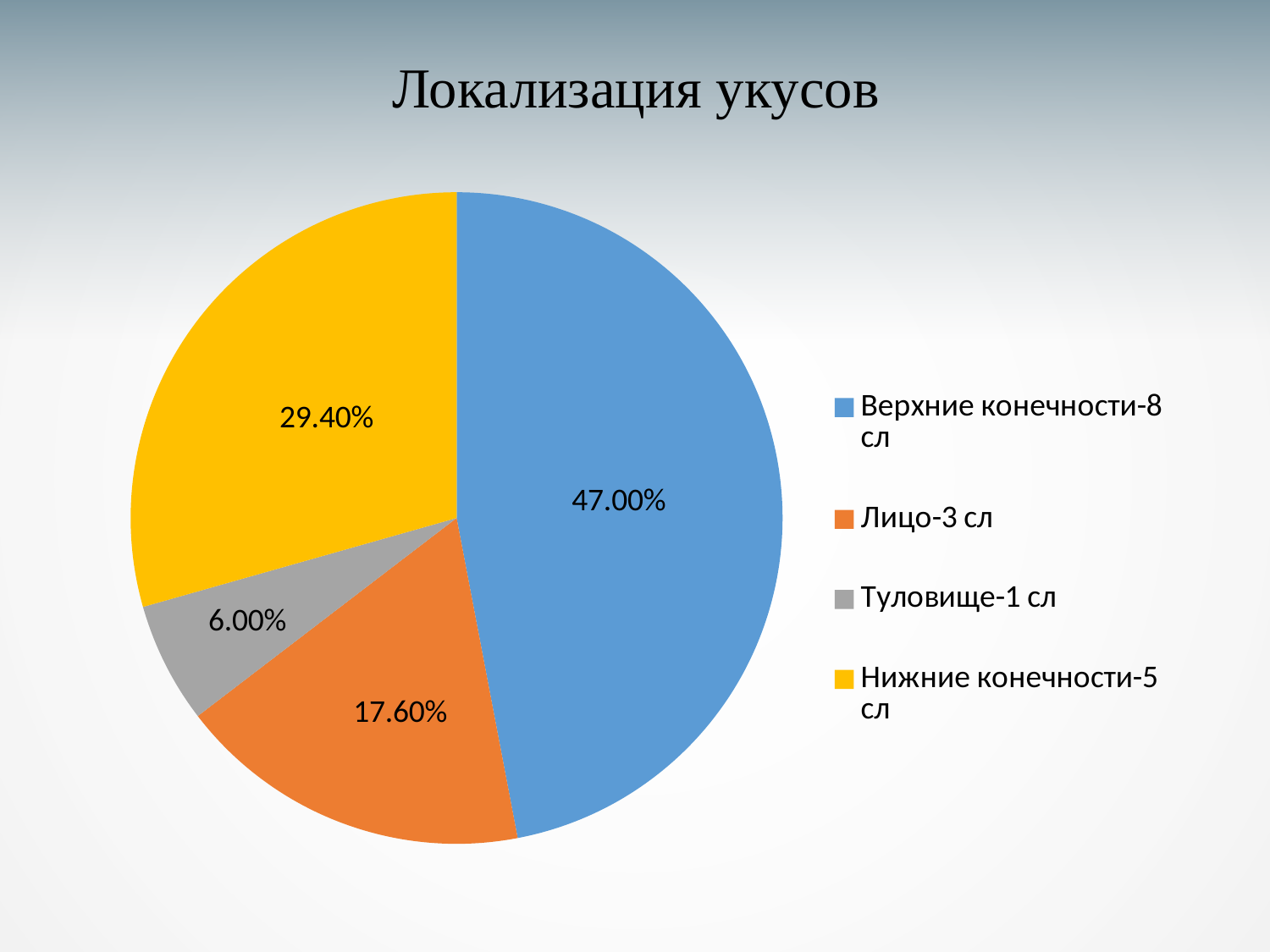
What is the value for Туловище-1 сл? 6.00% What kind of chart is shown on the slide? pie chart What is the value for Лицо-3 сл? 17.60% What is the difference between the values for Верхние конечности-8 сл and Нижние конечности-5 сл? 17.60% Which is larger, the value for Лицо-3 сл or the value for Нижние конечности-5 сл? Нижние конечности-5 сл What colour is the slice for Туловище-1 сл? grey Which category has the largest slice? Верхние конечности-8 сл How many slices does the pie chart have? 4 What is the value for Нижние конечности-5 сл? 29.40% What is the value for Верхние конечности-8 сл? 47.00% What is the title of the chart? Локализация укусов Which category has the smallest slice? Туловище-1 сл